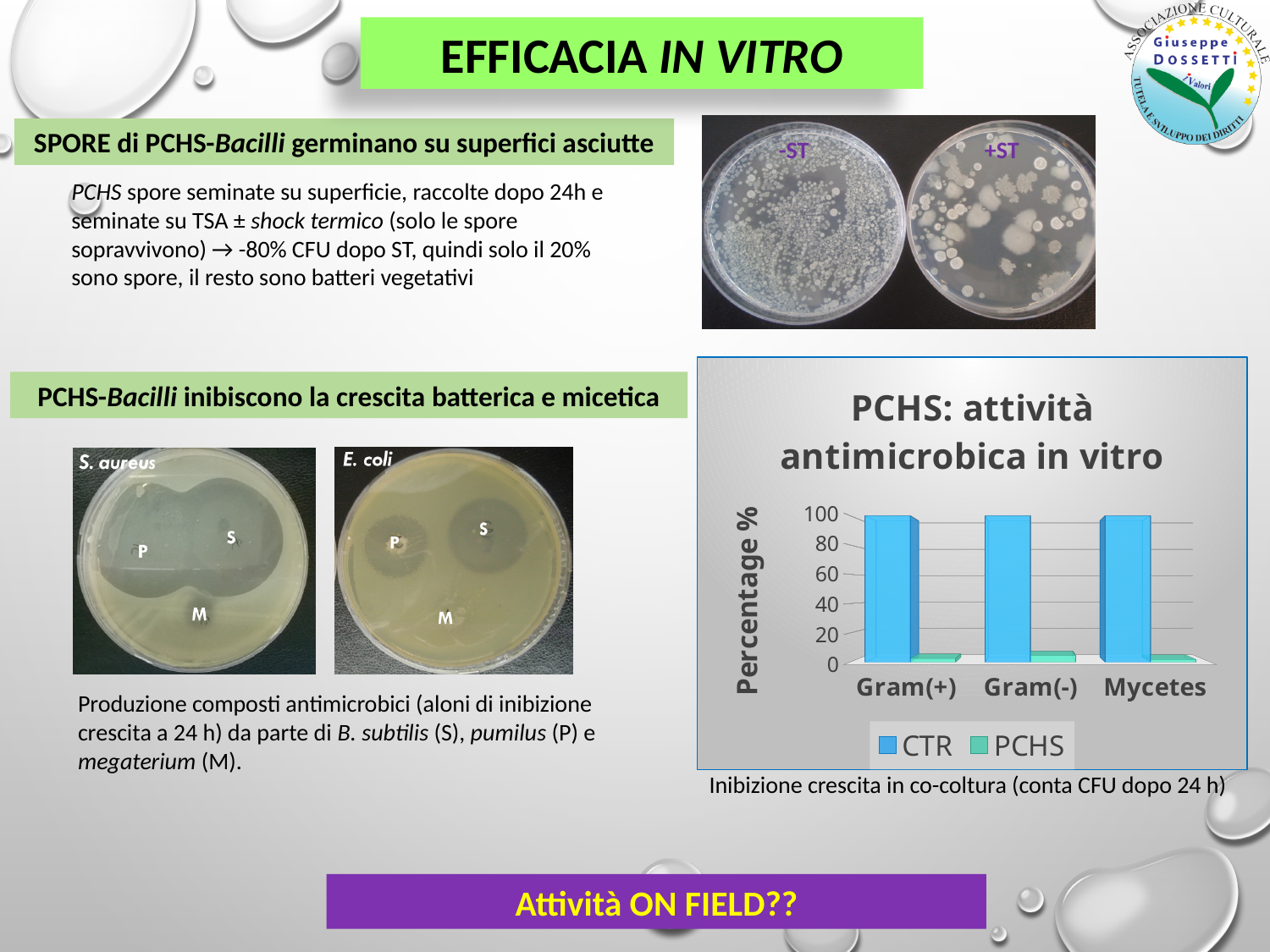
What is the title of the chart? PCHS: attività antimicrobica in vitro For Gram(+), which series has the larger value, CTR or PCHS? CTR How many series does the legend of the chart list? 2 Which series has the lowest values across all three categories in the chart? PCHS Is the CTR value for Gram(-) greater or less than 80? greater What kind of chart is shown on the slide? bar chart What are the two series named in the chart legend? CTR and PCHS How many categories are shown on the x axis of the chart? 3 Is the PCHS value for Mycetes greater or less than 20? less Is the PCHS value for Gram(+) greater or less than 40? less For Gram(-), which series has the larger value, CTR or PCHS? CTR